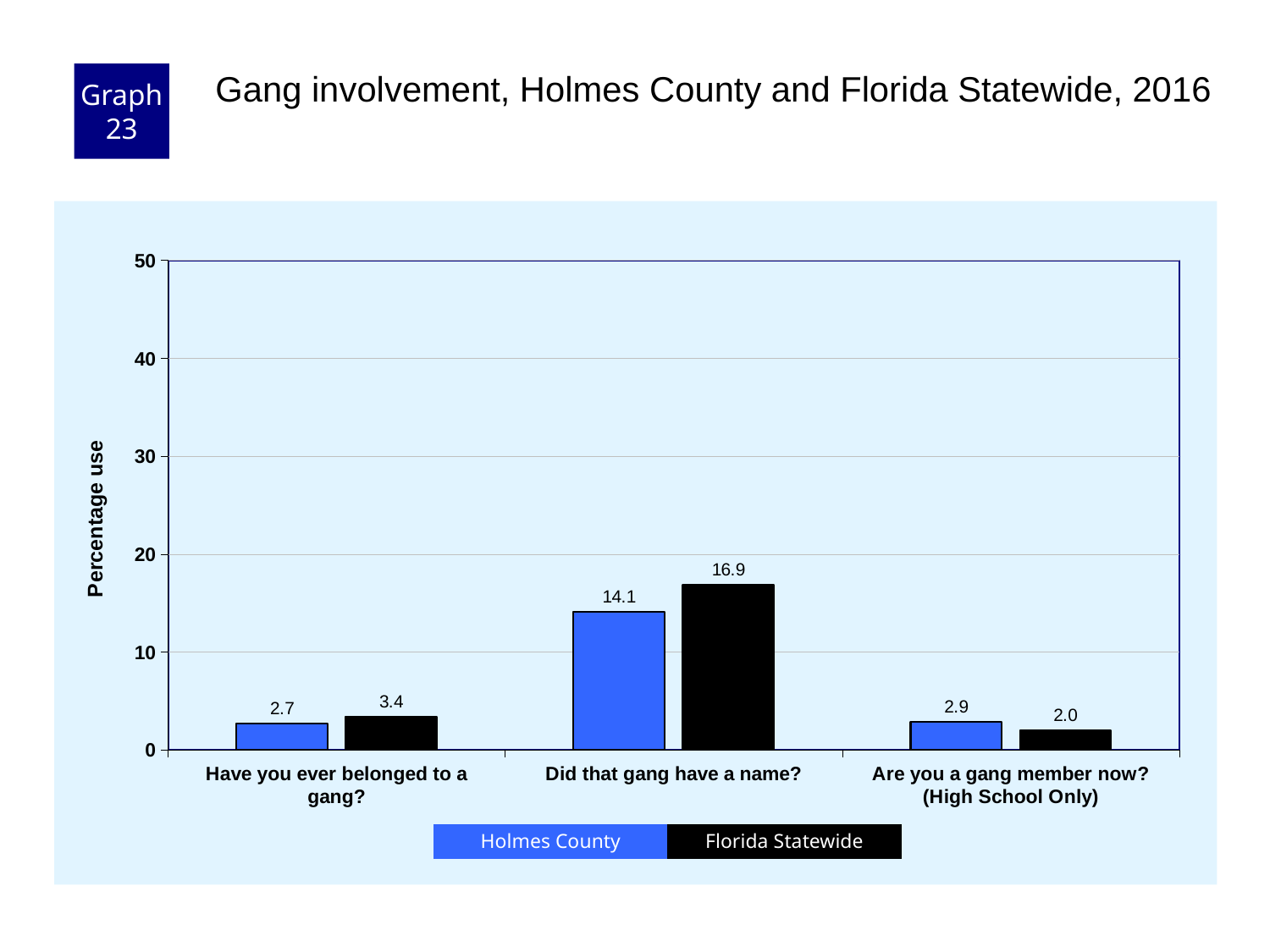
What is the label of the y axis? Percentage use Which category has the lowest Holmes County value? Have you ever belonged to a gang? What kind of chart is shown on the slide? Bar chart What is the Florida Statewide value for "Are you a gang member now? (High School Only)"? 2.0 For "Are you a gang member now? (High School Only)", which is larger: Holmes County or Florida Statewide? Holmes County How many categories are shown on the x axis? 3 What is the Holmes County value for "Did that gang have a name?"? 14.1 Which category has the highest Florida Statewide value? Did that gang have a name? How many series does the legend list? 2 What is the difference between the Florida Statewide and Holmes County values for "Did that gang have a name?"? 2.8 Is the Florida Statewide value for "Did that gang have a name?" greater or less than 20? less What is the Florida Statewide value for "Have you ever belonged to a gang?"? 3.4